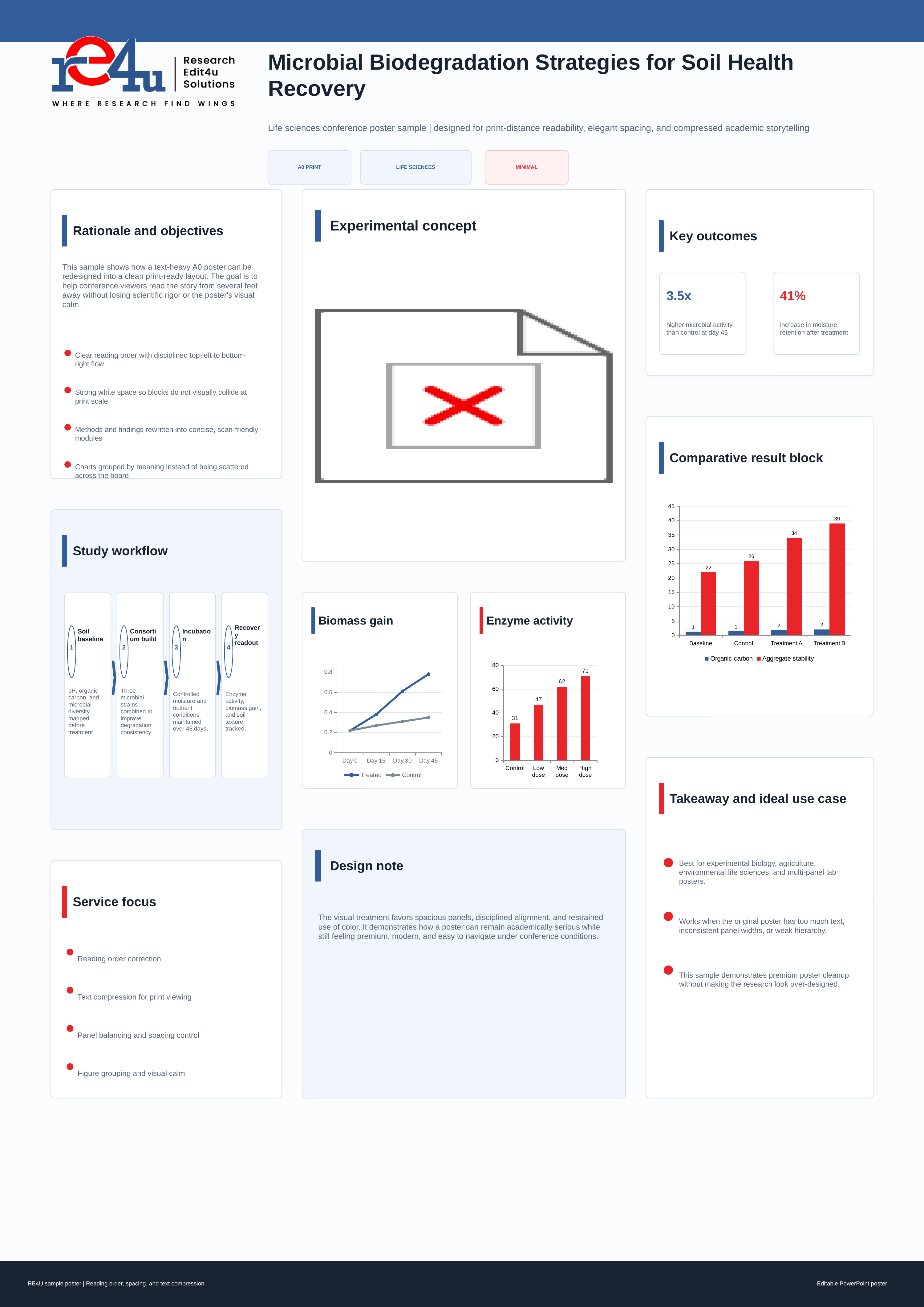
In the Enzyme activity chart, what is the value for High dose? 71 In the Comparative result block chart, what is the Organic carbon value for Control? 1 In the Comparative result block chart, what is the Aggregate stability value for Treatment A? 34 In the Enzyme activity chart, how many categories are shown on the x axis? 4 In the Comparative result block chart, how many series does the legend list? 2 In the Enzyme activity chart, what is the difference between Med dose and Low dose? 15 In the Comparative result block chart, what is the difference in Aggregate stability between Treatment B and Baseline? 17 What kind of chart is the Biomass gain chart? line chart In the Biomass gain chart, is the Treated value at Day 45 greater or less than 0.6? greater In the Comparative result block chart, which category has the highest Aggregate stability? Treatment B In the Enzyme activity chart, do the values rise or fall from Control to High dose? rise In the Enzyme activity chart, which category has the lowest value? Control